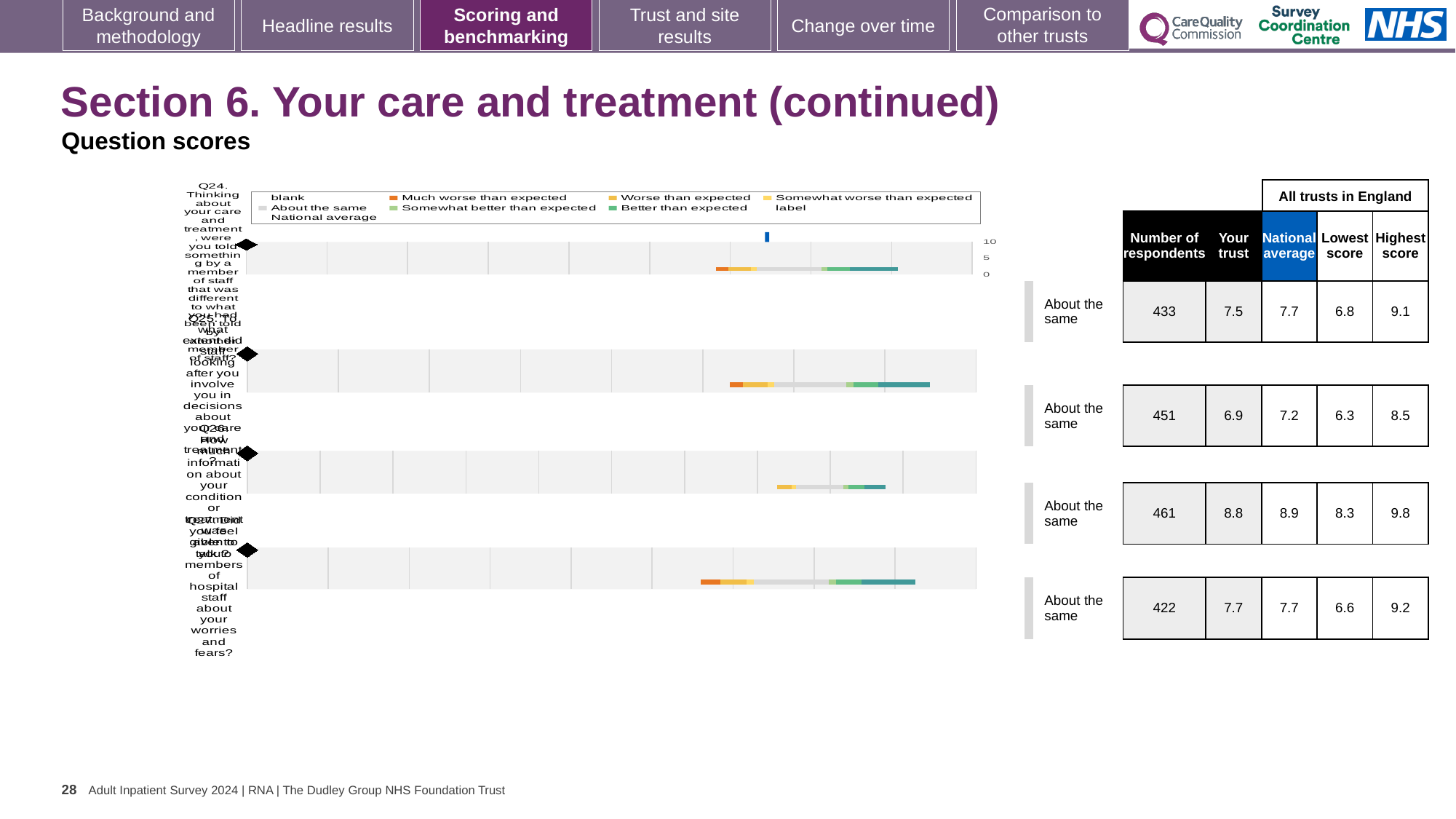
In the table to the right of the chart, which row has the largest number of respondents? the third row (461) In the table to the right of the chart, what is the 'Your trust' score in the second row? 6.9 In the table to the right of the chart, is the 'Your trust' score or the national average larger in the second row? National average In the table to the right of the chart, what is the national average in the third row? 8.9 In the table to the right of the chart, what is the difference between the highest score and the lowest score in the first row? 2.3 In the table to the right of the chart, what is the highest score in the fourth row? 9.2 In the table to the right of the chart, which row has the lowest 'Your trust' score? the second row (6.9) What kind of chart is shown on the slide? bar chart What benchmark label is shown next to each of the four bars? About the same Which legend entry appears first in the chart's legend? blank In the table to the right of the chart, what is the number of respondents in the first row? 433 How many horizontal bars does the chart contain? 4